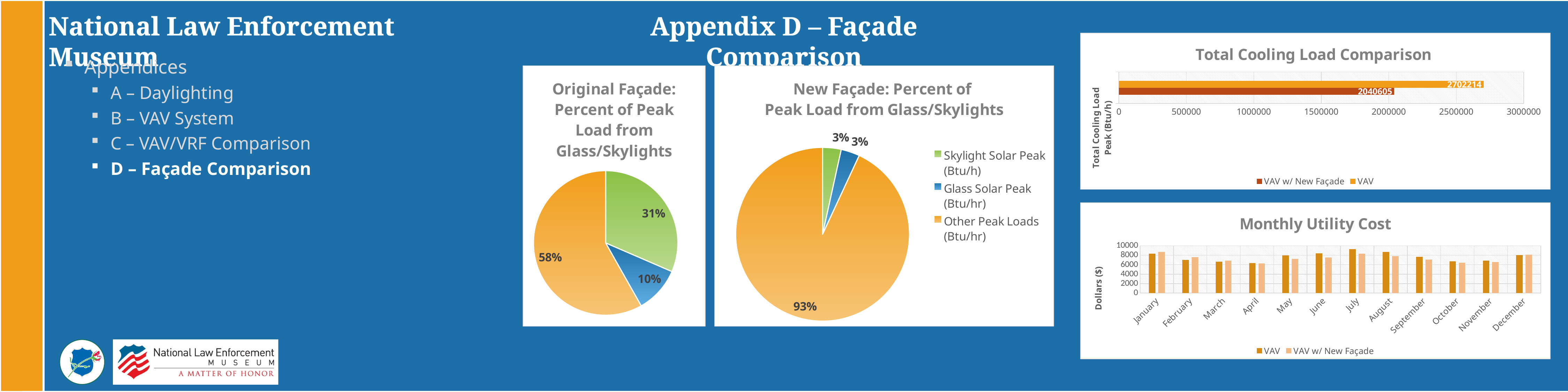
In the 'Original Façade: Percent of Peak Load from Glass/Skylights' pie chart, what share does the green slice represent? 31% In the 'New Façade: Percent of Peak Load from Glass/Skylights' pie chart, what share is Skylight Solar Peak (Btu/h)? 3% In the 'Total Cooling Load Comparison' chart, what is the value for VAV? 2702214 In the 'Monthly Utility Cost' chart, is the VAV value for July greater or less than 8000? greater In the 'Total Cooling Load Comparison' chart, what is the value for VAV w/ New Façade? 2040605 In the 'Original Façade: Percent of Peak Load from Glass/Skylights' pie chart, what is the largest slice's percentage? 58% In the 'New Façade: Percent of Peak Load from Glass/Skylights' pie chart, what share is Other Peak Loads (Btu/hr)? 93% How many months are shown on the x axis of the 'Monthly Utility Cost' chart? 12 In the 'Total Cooling Load Comparison' chart, what is the difference between the VAV value and the VAV w/ New Façade value? 661609 What kind of chart is 'Total Cooling Load Comparison'? Bar chart How many entries does the legend of the 'New Façade: Percent of Peak Load from Glass/Skylights' pie chart list? 3